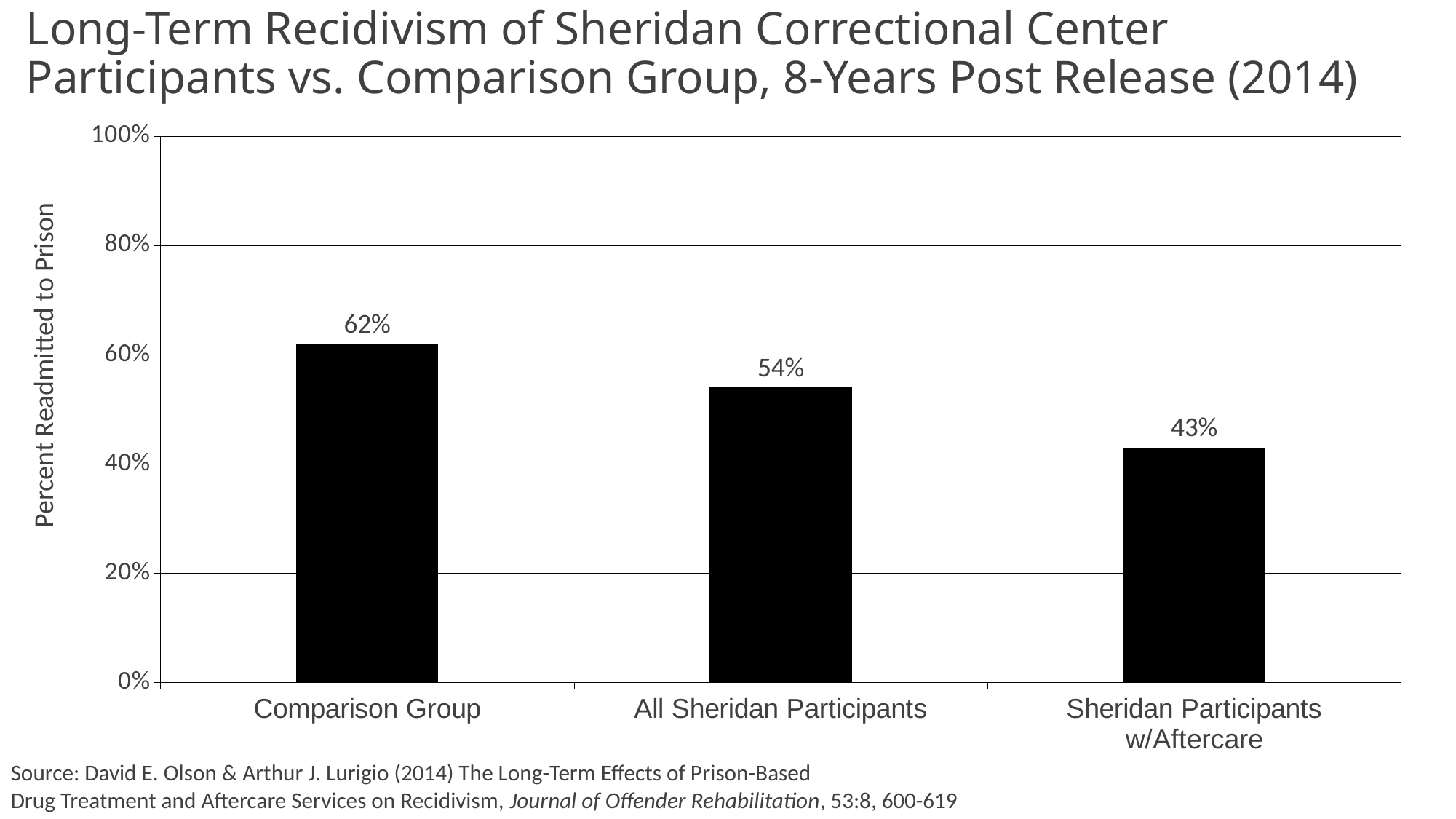
Which category has the highest percent readmitted to prison? Comparison Group What is the difference in percent readmitted between the Comparison Group and Sheridan Participants w/Aftercare? 19% What is the percent readmitted to prison for the Comparison Group? 62% Which category has the lowest percent readmitted to prison? Sheridan Participants w/Aftercare What is the difference in percent readmitted between the Comparison Group and All Sheridan Participants? 8% How many categories are shown on the chart? 3 Which has a higher percent readmitted to prison: All Sheridan Participants or Sheridan Participants w/Aftercare? All Sheridan Participants What is the label of the vertical axis? Percent Readmitted to Prison Is the value for Sheridan Participants w/Aftercare greater or less than 40%? greater What is the percent readmitted to prison for All Sheridan Participants? 54% What kind of chart is shown on the slide? Bar chart What is the percent readmitted to prison for Sheridan Participants w/Aftercare? 43%